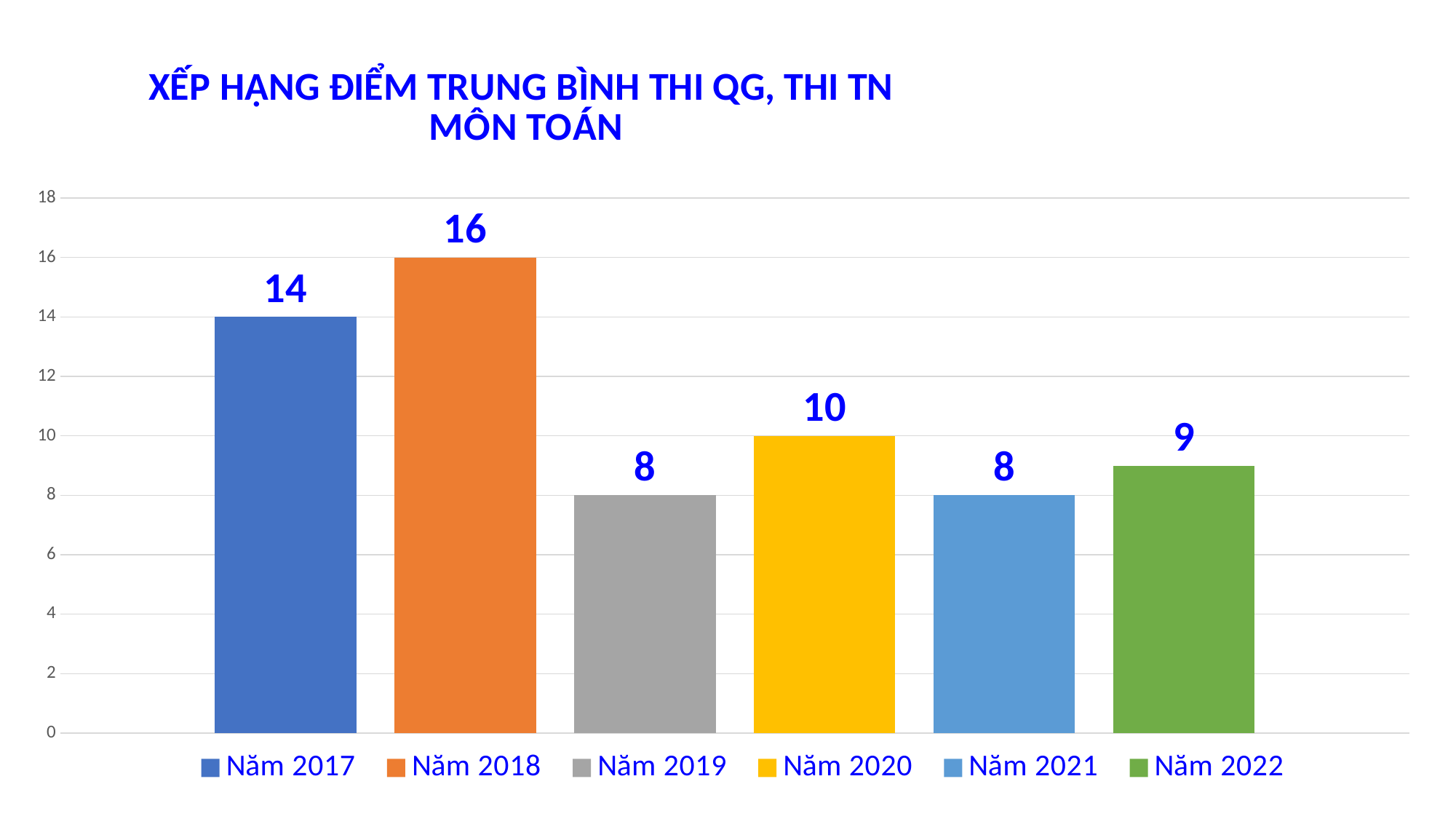
How many bars are shown in the chart? 6 What colour is the bar for Năm 2020? Yellow How many entries does the legend list? 6 What is the value for Năm 2020? 10 Is the value for Năm 2018 greater or less than 12? greater What is the value for Năm 2017? 14 What is the difference between the values for Năm 2018 and Năm 2017? 2 What is the difference between the values for Năm 2020 and Năm 2019? 2 Which year has the highest value? Năm 2018 What is the value for Năm 2022? 9 Which is larger, the value for Năm 2020 or the value for Năm 2022? Năm 2020 What kind of chart is shown on the slide? Bar chart